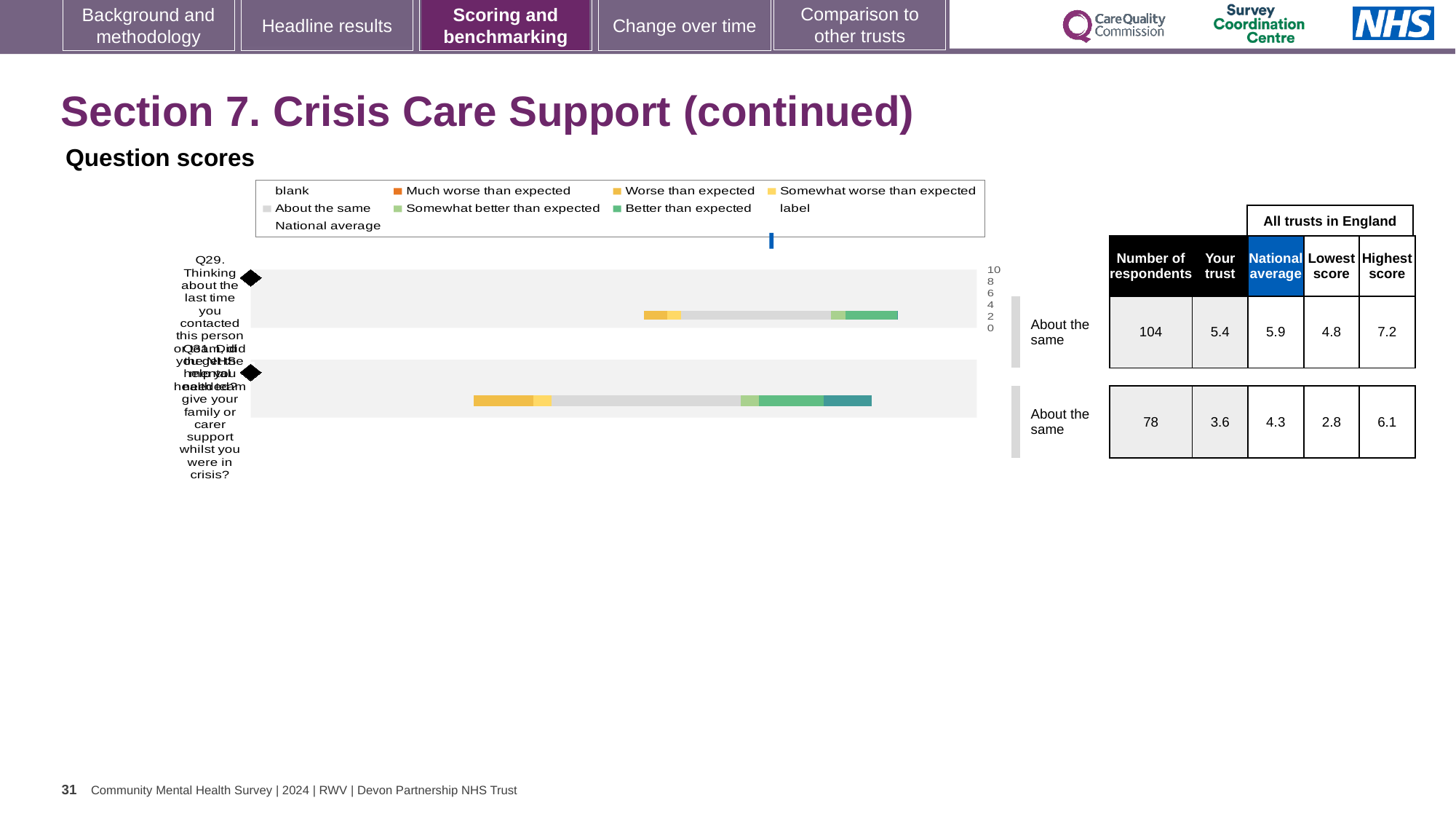
In the table next to the chart, what is the highest score for Q31? 6.1 In the table next to the chart, what is the national average for Q31? 4.3 How many entries does the chart legend list? 9 In the table next to the chart, what is the 'Your trust' score for Q29? 5.4 In the table next to the chart, what is the difference between the national average and the 'Your trust' score for Q31? 0.7 What kind of chart is shown under 'Question scores'? bar chart In the table next to the chart, which question has the higher 'Your trust' score, Q29 or Q31? Q29 What is the highest tick value shown on the chart's axis? 10 In the table next to the chart, what is the lowest score for Q29? 4.8 In the table next to the chart, what is the number of respondents for Q29? 104 How many questions (categories) are plotted in the chart? 2 What colour does the legend use for 'Much worse than expected'? orange